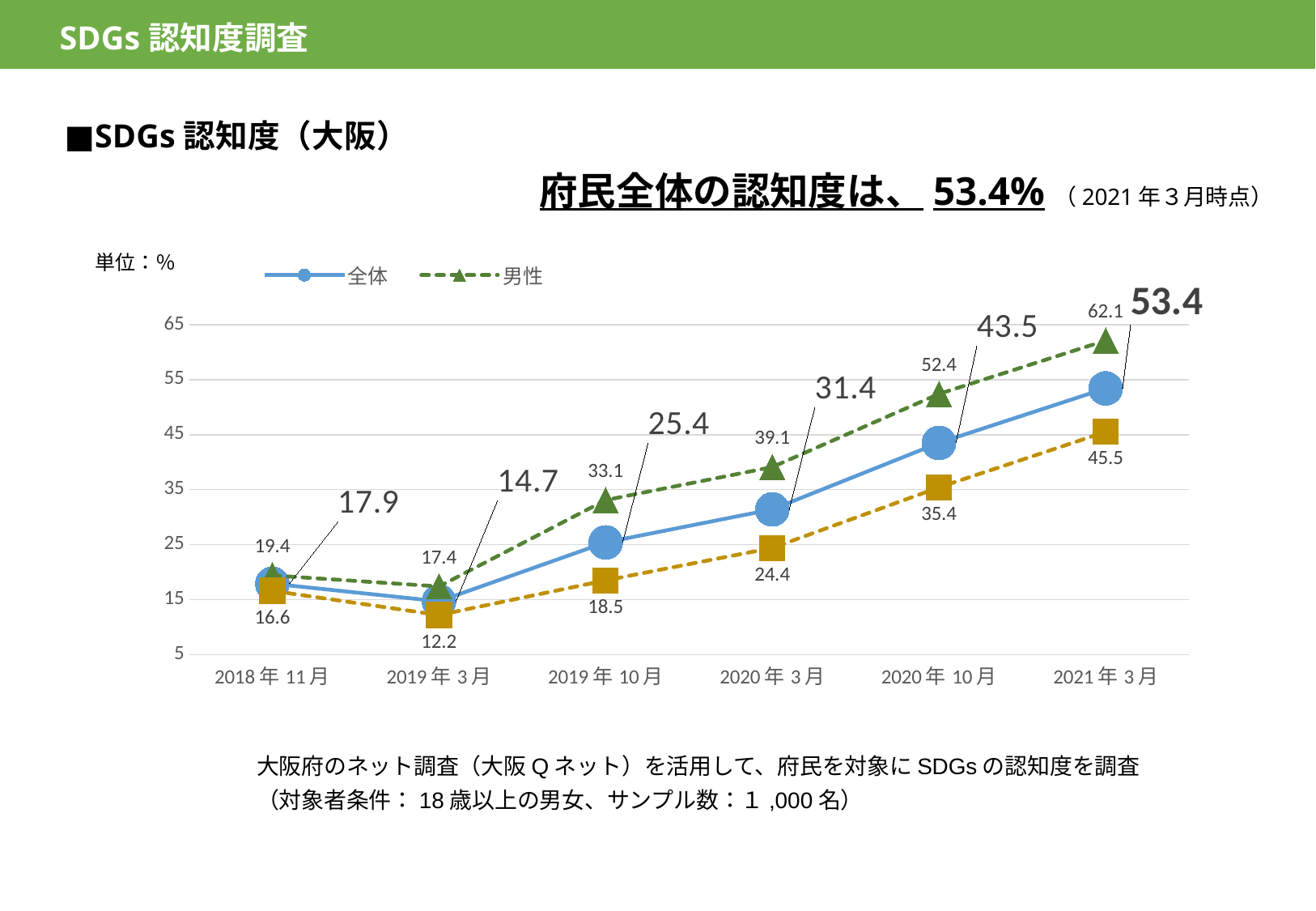
How many time points are plotted on the x axis? 6 How many series does the legend list? 2 What is the value for 全体 at 2018年11月? 17.9 At which time point is the 男性 series highest? 2021年3月 What is the value for 全体 at 2021年3月? 53.4 Is the value for 全体 at 2020年10月 greater or less than 45? less What is the value for 男性 at 2019年10月? 33.1 What is the difference between 男性 and 全体 at 2021年3月? 8.7 Which is larger at 2020年3月, 全体 or 男性? 男性 What kind of chart is shown on the slide? line chart At which time point is the 全体 series lowest? 2019年3月 How much did the 全体 value increase from 2020年3月 to 2020年10月? 12.1